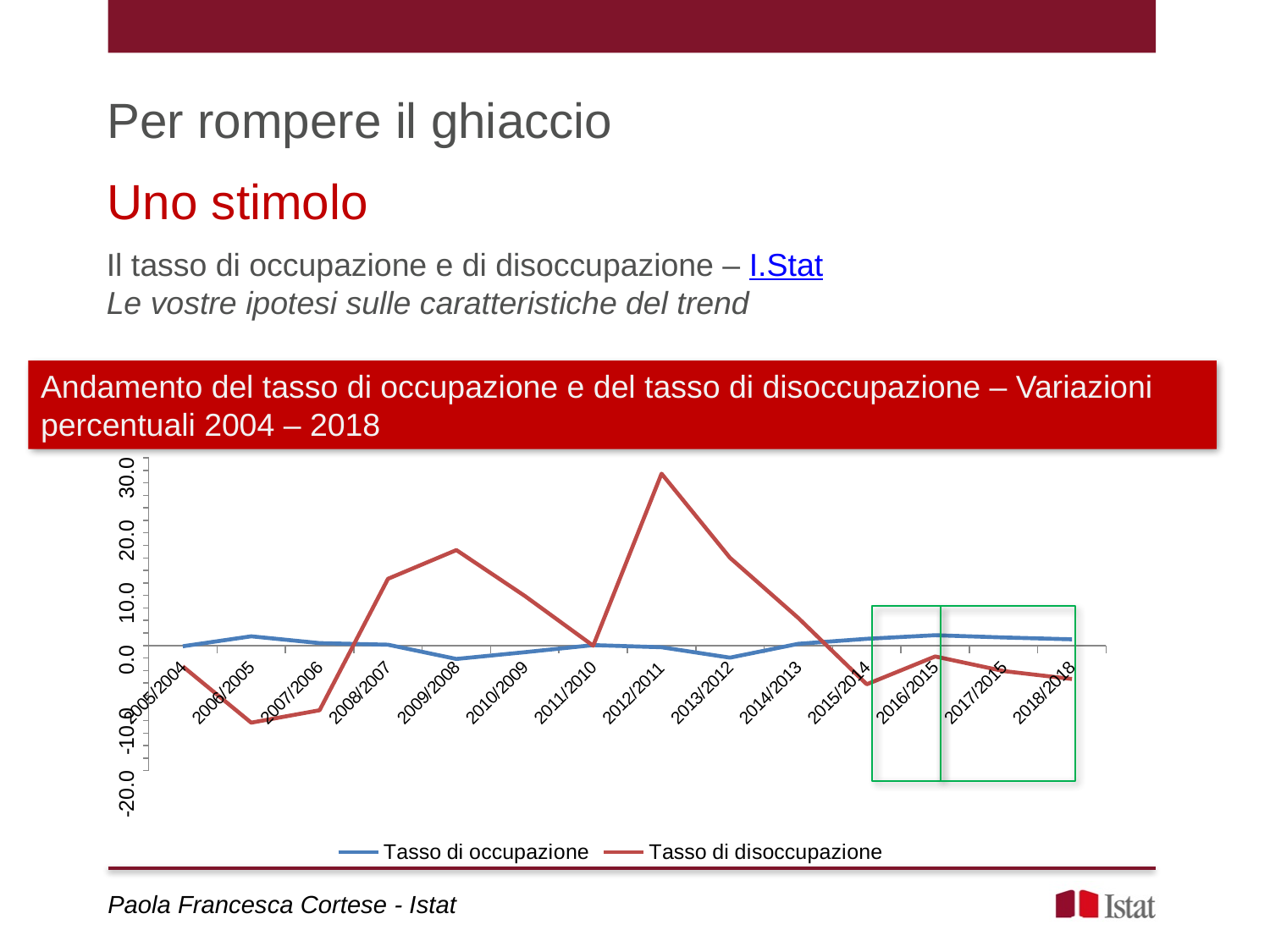
In which period does the Tasso di disoccupazione series reach its highest value? 2012/2011 In which period does the Tasso di disoccupazione series reach its lowest value? 2006/2005 How many series does the legend list? 2 Is the value of Tasso di disoccupazione for 2012/2011 greater or less than 20.0? greater Is the value of Tasso di disoccupazione for 2013/2012 greater or less than 10.0? greater Does the Tasso di disoccupazione series rise or fall from 2012/2011 to 2015/2014? Fall Is the value of Tasso di occupazione for 2006/2005 greater or less than 10.0? less For 2012/2011, which series has the larger value, Tasso di occupazione or Tasso di disoccupazione? Tasso di disoccupazione Which colour is used for the Tasso di disoccupazione line? Red How many periods are plotted along the x axis? 14 What kind of chart is shown on the slide? Line chart